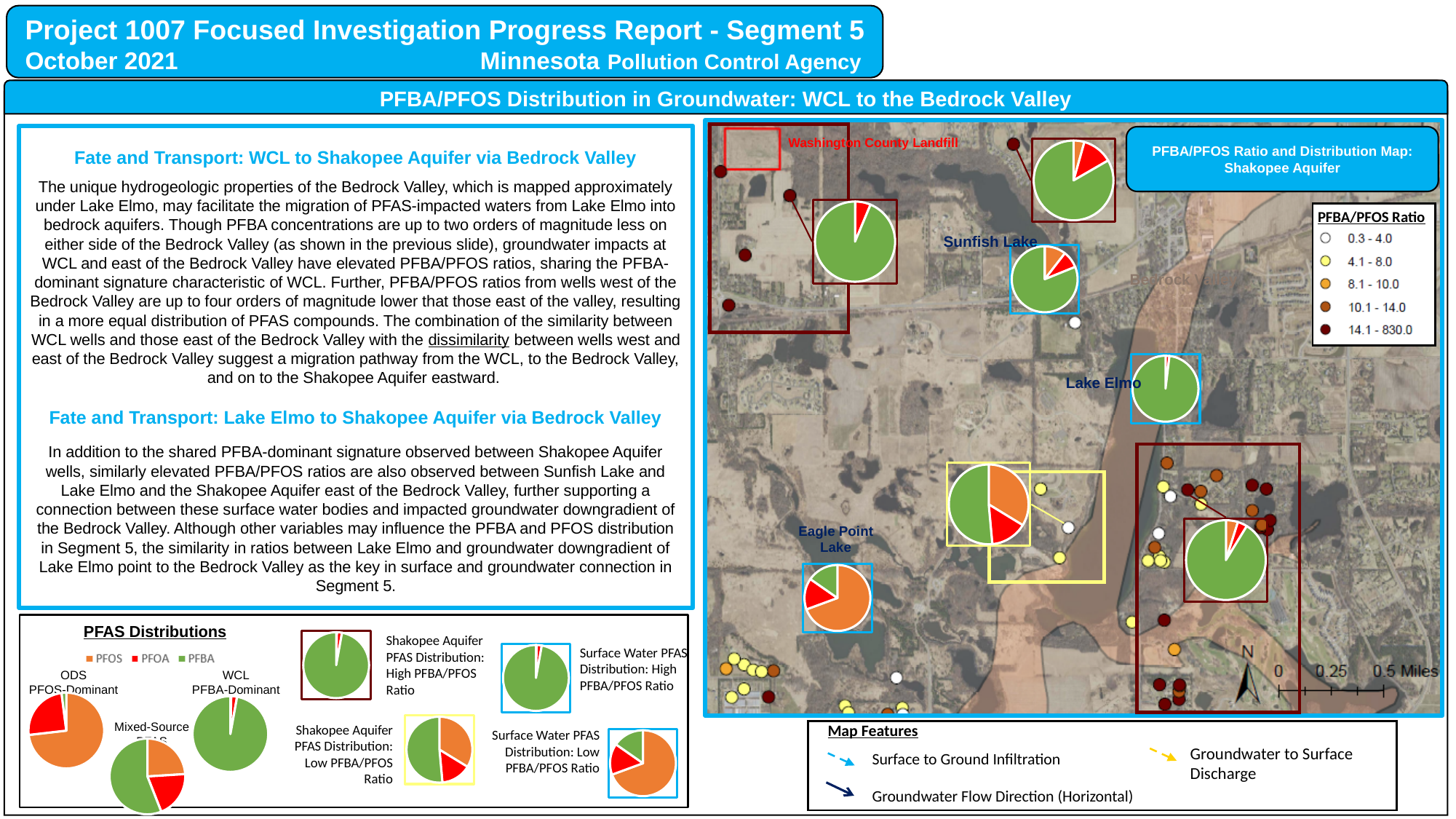
In the PFAS Distributions panel, which colour represents PFBA? green What kind of chart is used in the PFAS Distributions panel at the bottom left of the slide? pie chart On the map, which compound has the largest slice in the Eagle Point Lake pie chart? PFOS How many series does the legend in the PFAS Distributions panel list? 3 On the map, which compound has the largest slice in the Lake Elmo pie chart? PFBA In the Mixed-Source PFAS pie chart, which slice is larger, PFBA or PFOA? PFBA How many pie charts are shown in the PFAS Distributions panel at the bottom left? 7 What are the legend entries in the PFAS Distributions panel? PFOS, PFOA, PFBA In the WCL PFBA-Dominant pie chart, which compound has the largest slice? PFBA